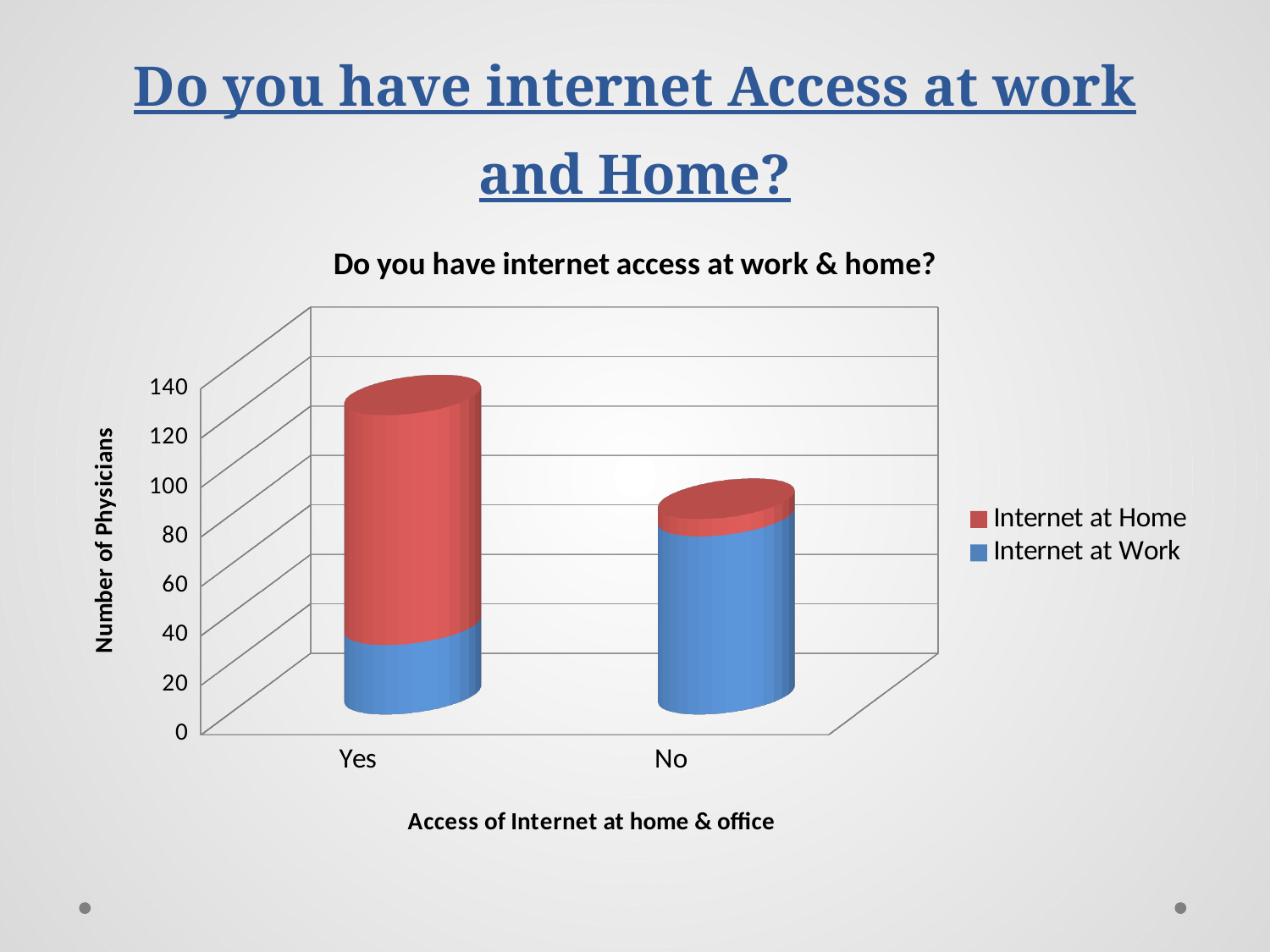
Which series is shown in red in the chart's legend? Internet at Home What kind of chart is shown on the slide? Stacked bar chart Is the total height of the stacked bar for Yes greater or less than 100? greater Is the Internet at Work value for Yes greater or less than 60? less Which category has the larger Internet at Work value, Yes or No? No Is the total height of the stacked bar for No greater or less than 120? less Which category has the larger Internet at Home value, Yes or No? Yes How many series does the chart's legend list? 2 How many categories are shown on the x axis of the chart? 2 What is the label of the chart's vertical axis? Number of Physicians Which category has the taller stacked bar, Yes or No? Yes